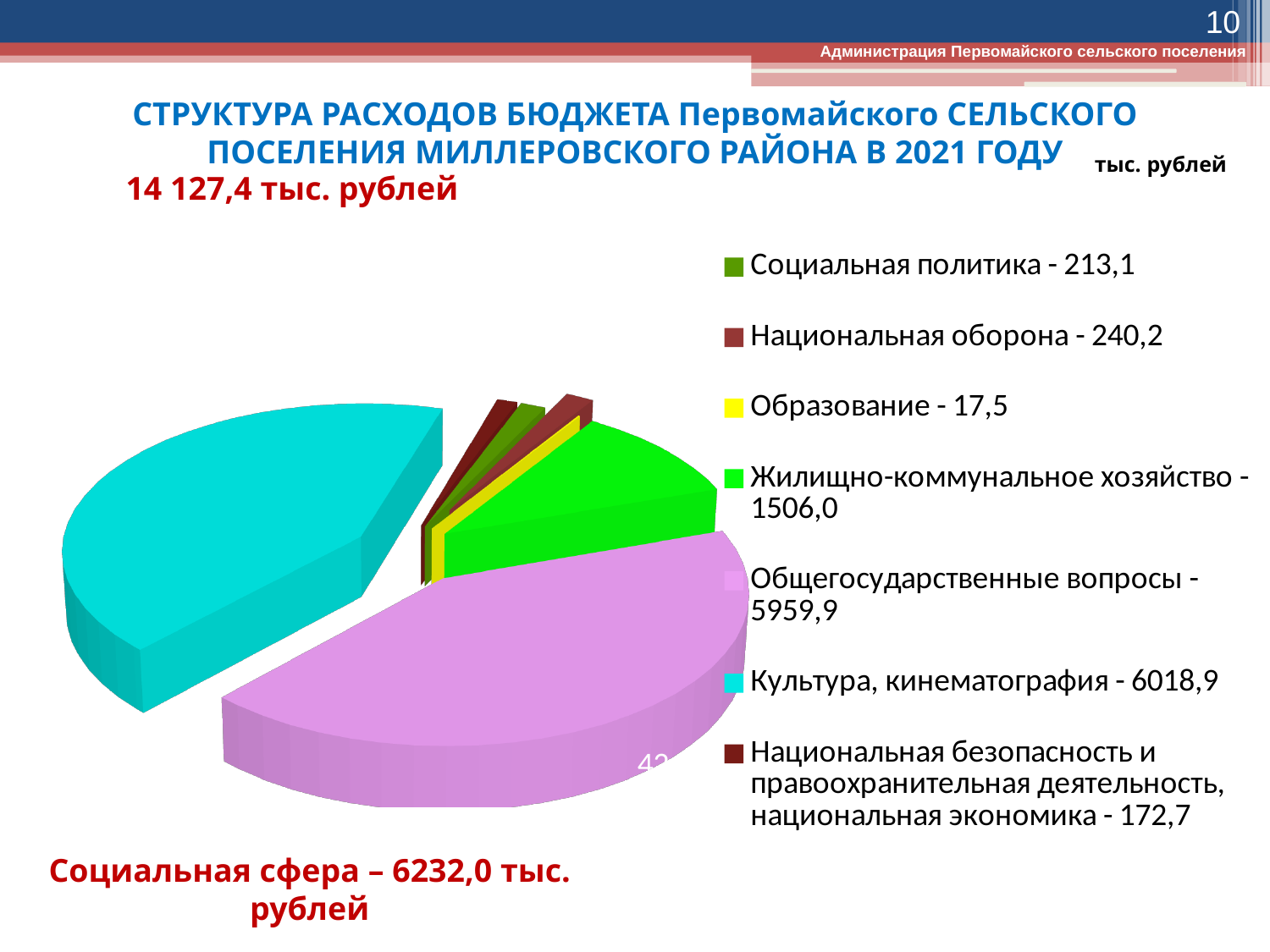
What type of chart is shown on the slide? Pie chart How many categories does the pie chart legend list? 7 Which is larger: Социальная политика or Национальная оборона? Национальная оборона What is the difference between the values for Культура, кинематография and Общегосударственные вопросы? 59,0 What value is shown for Общегосударственные вопросы? 5959,9 What value is shown for Образование in the legend? 17,5 What is the difference between the values for Национальная оборона and Социальная политика? 27,1 What value is shown for Национальная оборона? 240,2 In what units are the chart values given, according to the label at the top right? тыс. рублей What value is shown for Жилищно-коммунальное хозяйство? 1506,0 Which category has the largest value in the pie chart? Культура, кинематография Which category has the smallest value in the pie chart? Образование